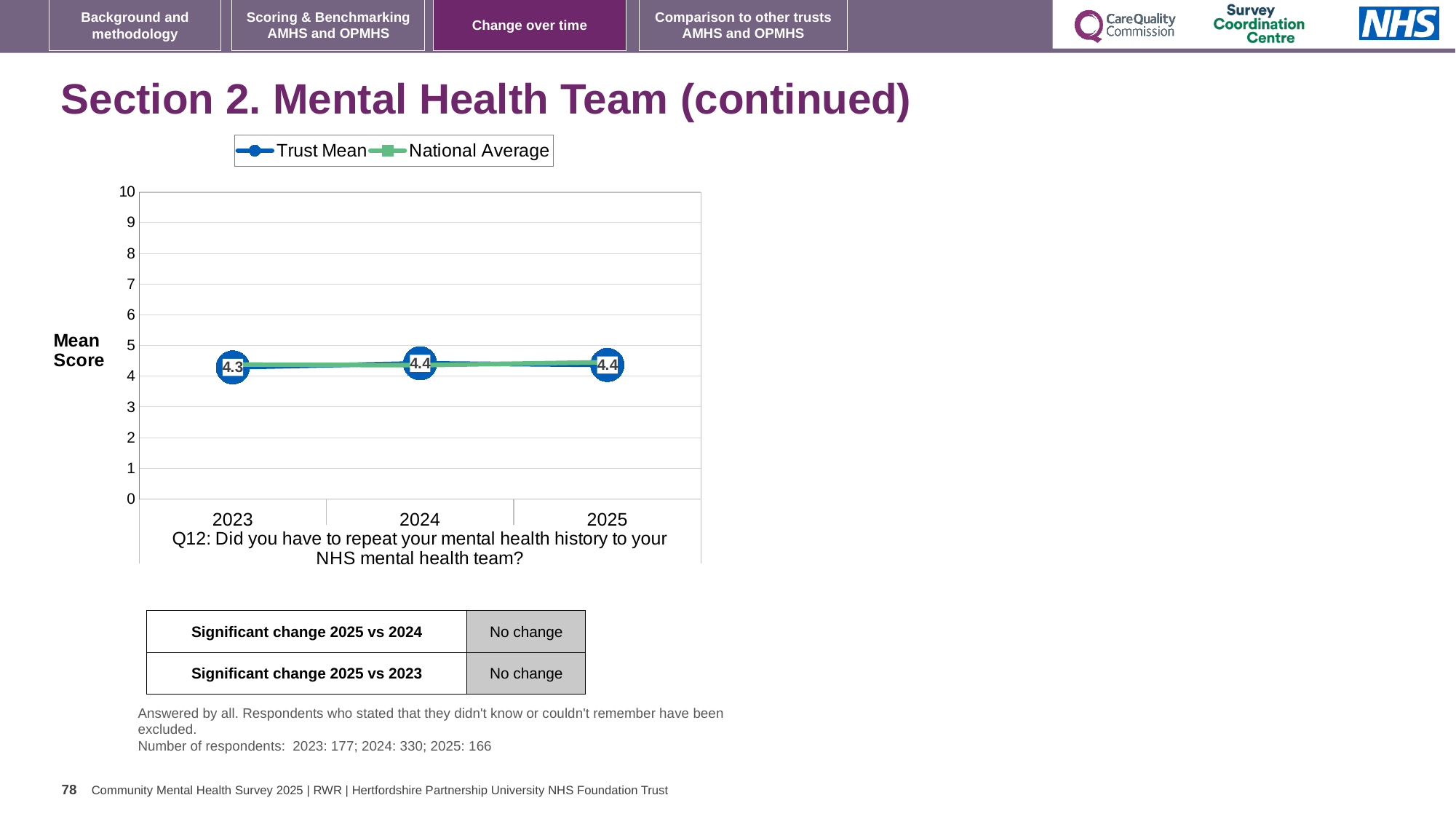
Is the Trust Mean for 2024 larger or smaller than the Trust Mean for 2023? Larger How many years are plotted on the x axis? 3 What is the Trust Mean value for 2023? 4.3 Does the Trust Mean rise or fall from 2023 to 2025? Rise What is the Trust Mean value for 2025? 4.4 What is the difference between the Trust Mean for 2024 and for 2023? 0.1 What is the label on the y axis of the chart? Mean Score Which year has the lowest Trust Mean value? 2023 Is the Trust Mean value for 2025 greater or less than 5? less What is the Trust Mean value for 2024? 4.4 How many series does the legend list? 2 What kind of chart is shown on the slide? Line chart